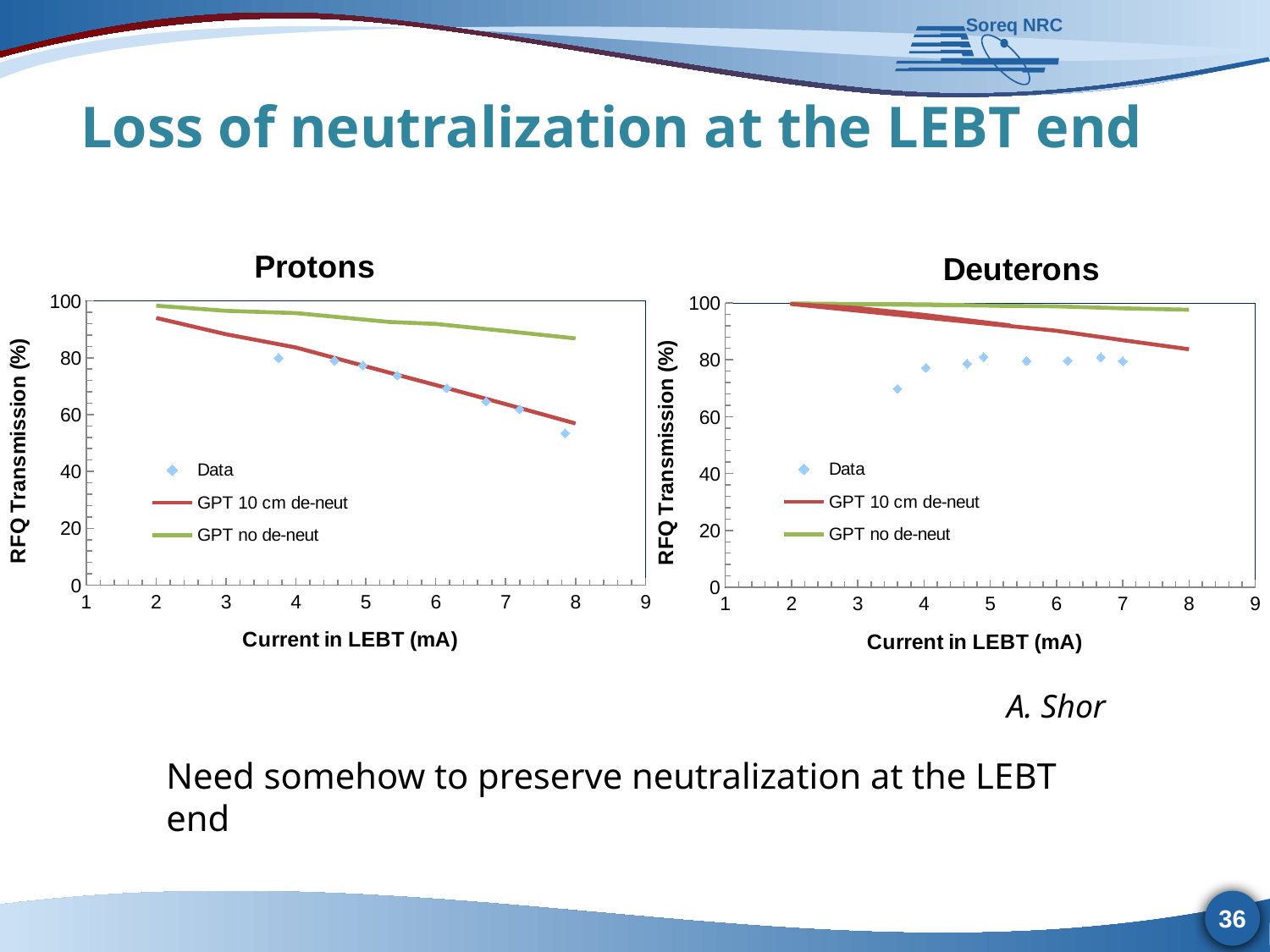
In the Protons chart, does the GPT 10 cm de-neut line rise or fall as current in LEBT increases? Fall In the Deuterons chart, is the lowest Data point greater or less than 80? less In the Protons chart, is the GPT 10 cm de-neut value at 8 mA greater or less than 60? less In the Protons chart, is the GPT no de-neut value at 8 mA greater or less than 80? greater In the Protons chart, how many series does the legend list? 3 In the Protons chart, how many Data points are plotted? 8 In the Deuterons chart, does the GPT 10 cm de-neut line rise or fall as current in LEBT increases? Fall What kind of chart is the Protons chart? Line chart with scatter points In the Protons chart, at 8 mA, which line is higher: GPT no de-neut or GPT 10 cm de-neut? GPT no de-neut What is the y-axis label of the Deuterons chart? RFQ Transmission (%) In the Deuterons chart, what are the three legend entries? Data, GPT 10 cm de-neut, GPT no de-neut